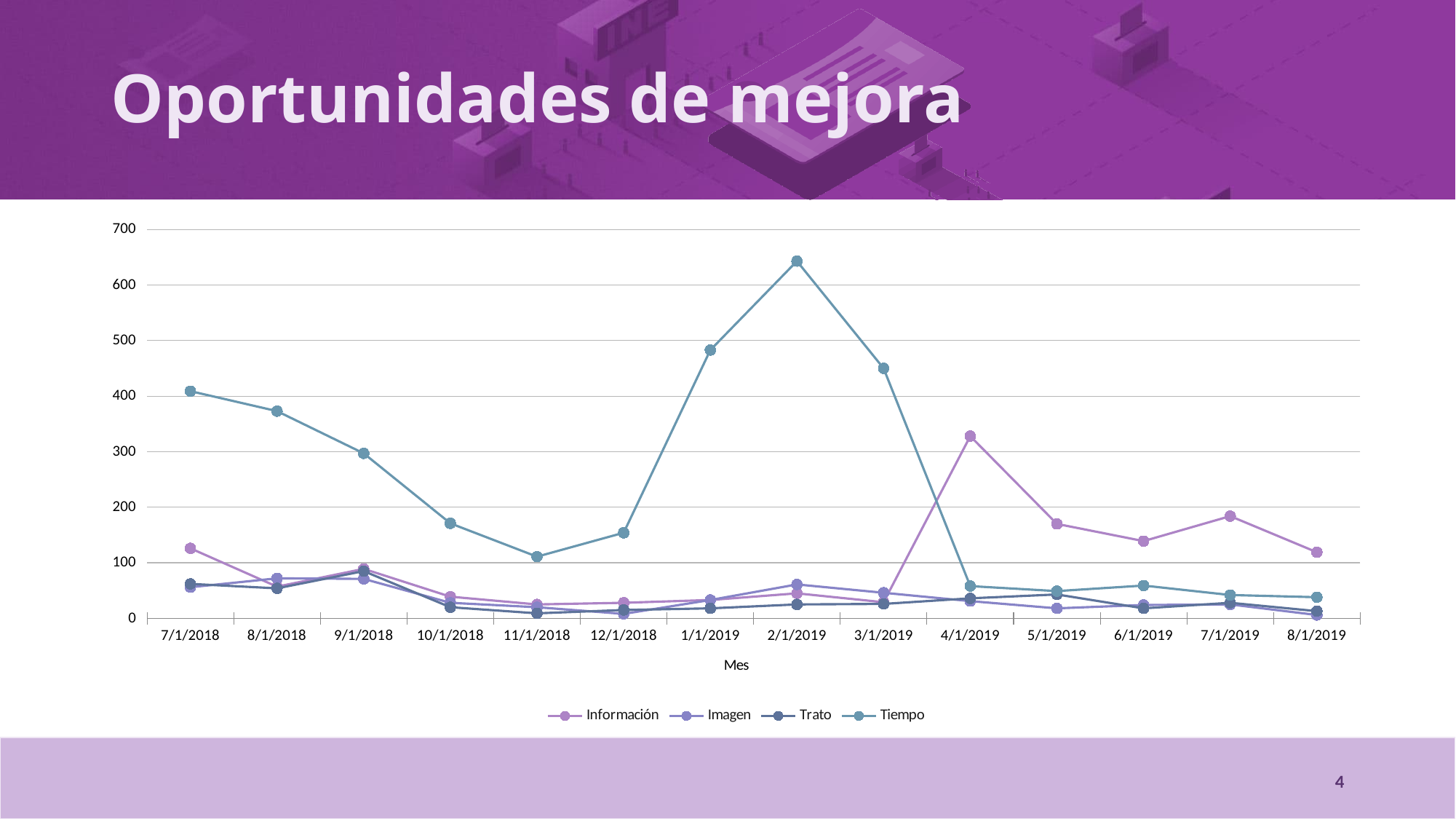
Is the value for Tiempo at 11/1/2018 greater or less than 200? less At which month does the Información series reach its highest value? 4/1/2019 Does the Tiempo series rise or fall from 7/1/2018 to 11/1/2018? fall Is the value for Tiempo at 2/1/2019 greater or less than 600? greater At 1/1/2019, which series has the larger value, Tiempo or Información? Tiempo At which month does the Tiempo series reach its highest value? 2/1/2019 Is the value for Tiempo at 7/1/2018 greater or less than 300? greater How many series does the legend list? 4 At 4/1/2019, which series has the larger value, Información or Tiempo? Información How many months are plotted along the x axis? 14 What kind of chart is shown on the slide? line chart